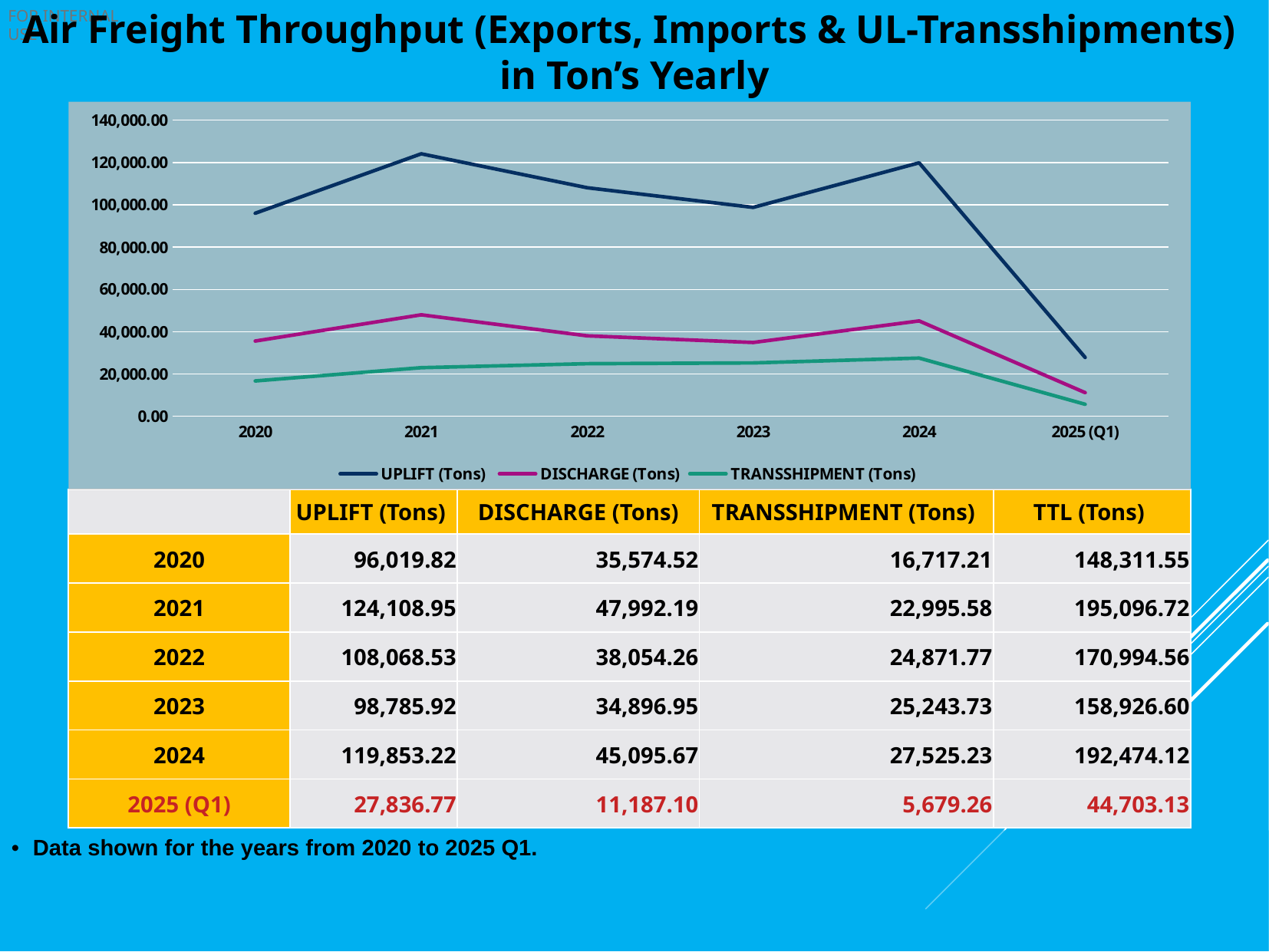
Which is larger, DISCHARGE (Tons) in 2021 or in 2024? 2021 What is the difference between the UPLIFT (Tons) values for 2024 and 2023? 21,067.30 In which period is UPLIFT (Tons) highest? 2021 What is the TRANSSHIPMENT (Tons) value for 2022? 24,871.77 How many series does the chart legend list? 3 Does the UPLIFT (Tons) line rise or fall from 2024 to 2025 (Q1)? fall What colour is the UPLIFT (Tons) line in the chart? dark navy blue Is the UPLIFT (Tons) value for 2025 (Q1) greater or less than 40,000.00? less What kind of chart is shown on the slide? line chart What is the UPLIFT (Tons) value for 2021? 124,108.95 How many time periods are plotted along the x axis of the chart? 6 In which period is TRANSSHIPMENT (Tons) lowest? 2025 (Q1)